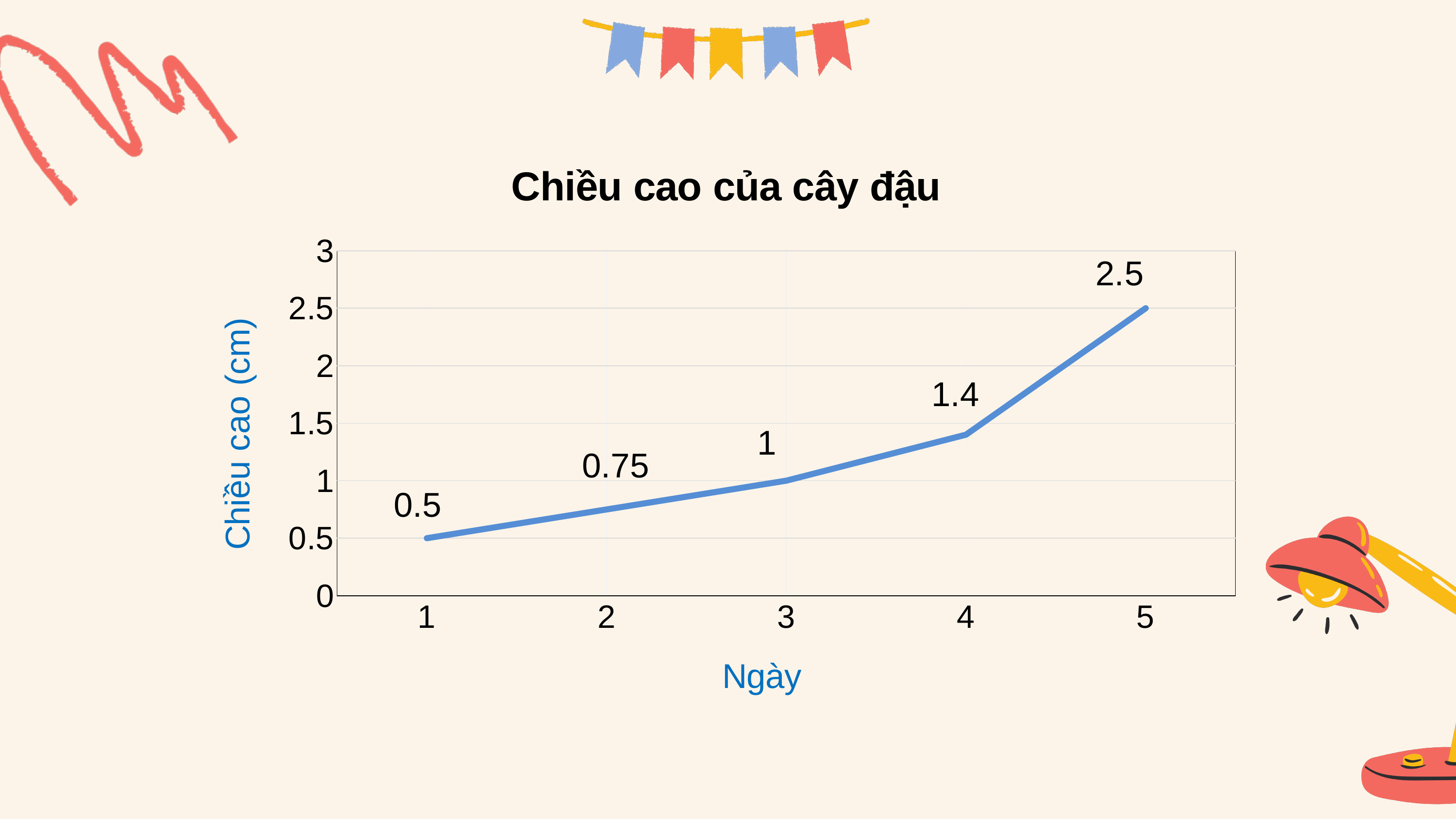
What is the height of the bean plant on day 3? 1 Is the value for day 4 greater or less than 1.5? less What kind of chart is shown on the slide? line chart How many data points are plotted on the chart? 5 What is the difference in height between day 5 and day 4? 1.1 What is the height of the bean plant on day 5? 2.5 On which day is the plant height highest? 5 Do the values rise or fall from day 1 to day 5? rise What is the height of the bean plant on day 1? 0.5 Which day has a greater height, day 2 or day 4? 4 On which day is the plant height lowest? 1 What is the difference in height between day 2 and day 1? 0.25